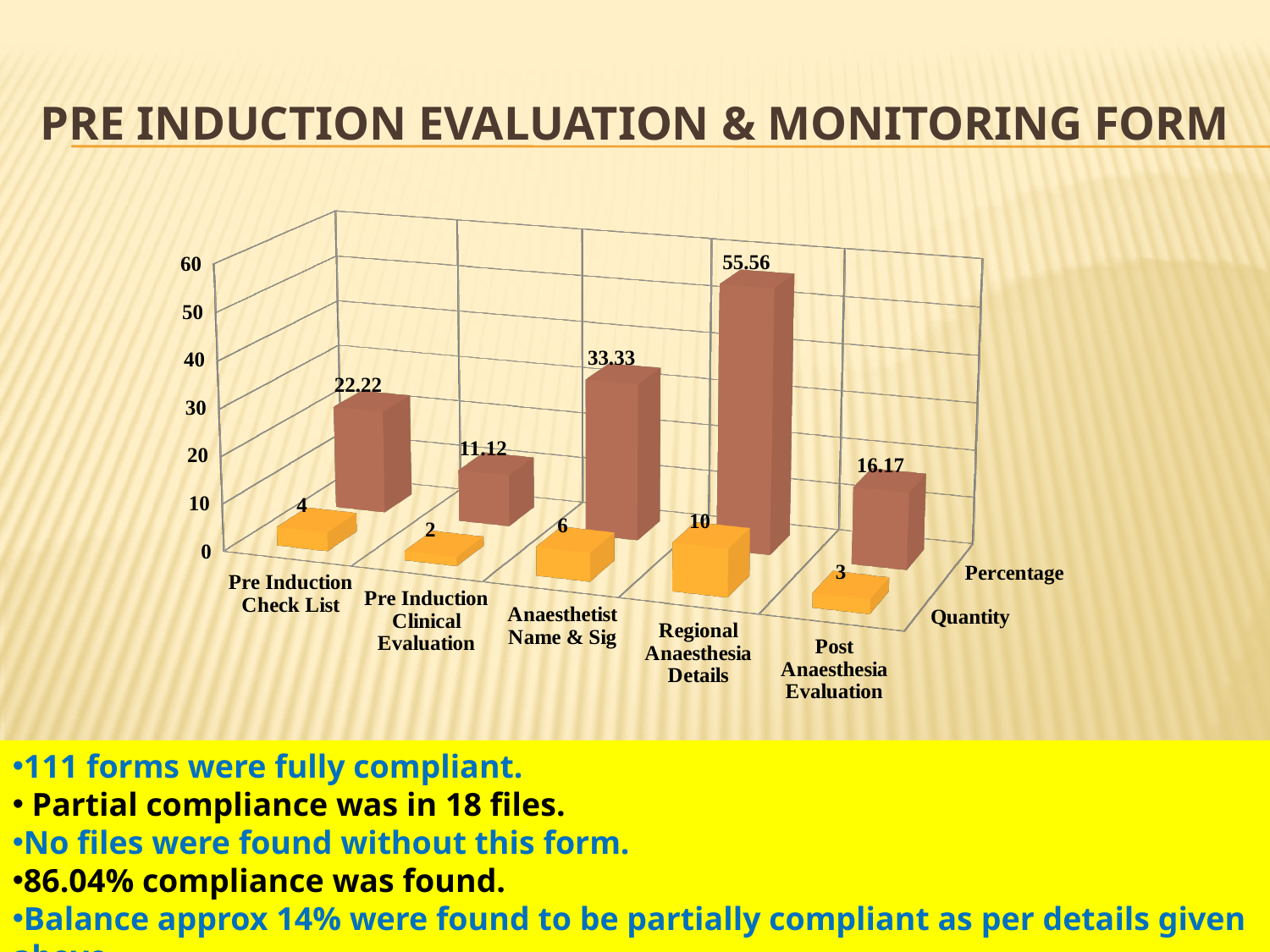
How many categories are shown on the chart? 5 What is the Quantity value for Anaesthetist Name & Sig? 6 How many data series does the chart show? 2 What is the Quantity value for Post Anaesthesia Evaluation? 3 What type of chart is shown on the slide? Bar chart Which category has the lowest Quantity value? Pre Induction Clinical Evaluation What is the Percentage value for Pre Induction Clinical Evaluation? 11.12 What is the difference between the Quantity values for Regional Anaesthesia Details and Pre Induction Check List? 6 Which category has the highest Percentage value? Regional Anaesthesia Details What is the Percentage value for Regional Anaesthesia Details? 55.56 What is the title of the slide containing the chart? PRE INDUCTION EVALUATION & MONITORING FORM Which is larger, the Percentage value for Pre Induction Check List or for Post Anaesthesia Evaluation? Pre Induction Check List